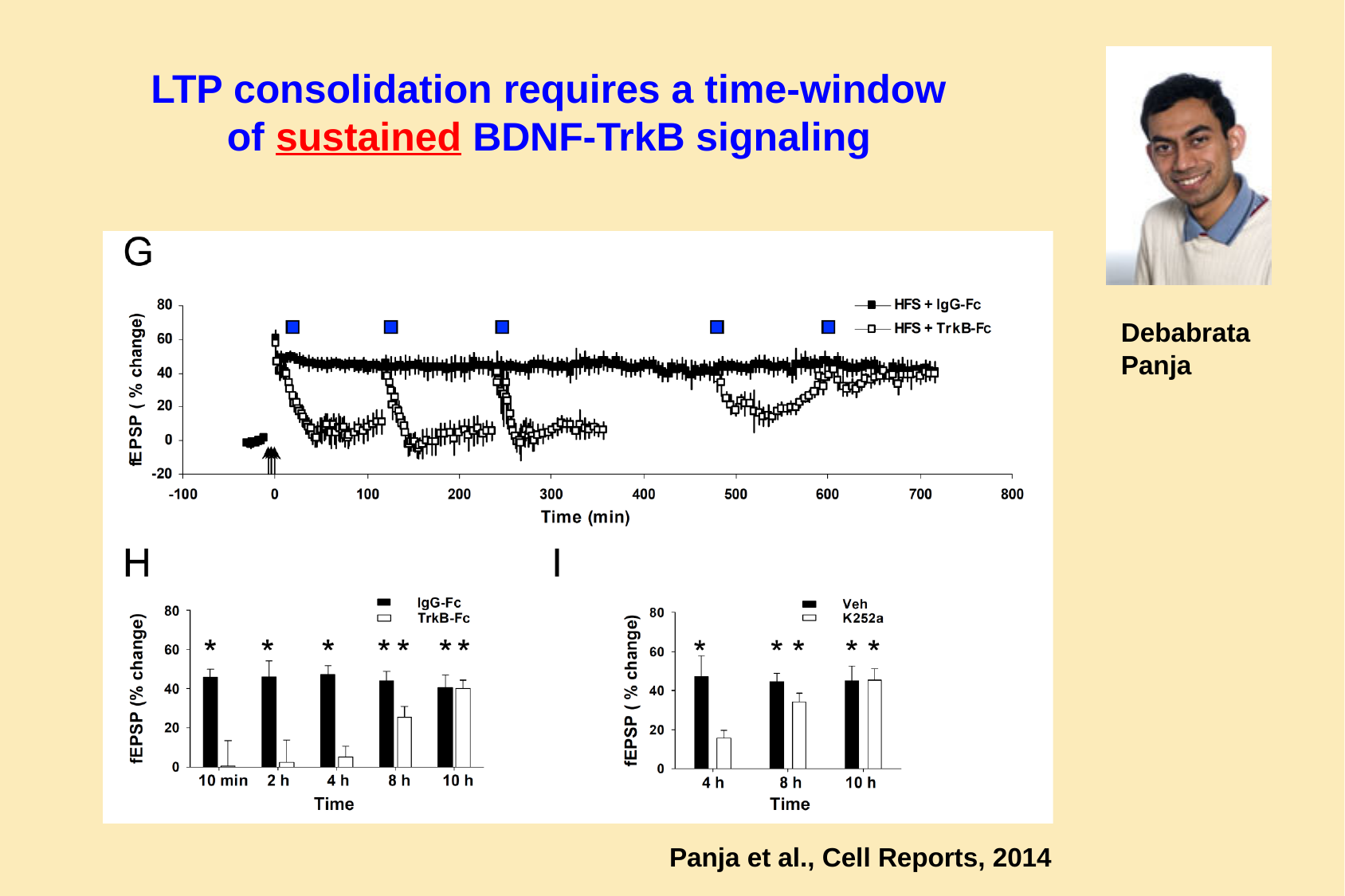
In chart H (bottom left), which series has the larger value at 8 h, IgG-Fc or TrkB-Fc? IgG-Fc In chart G (the top chart), which series has the higher value at 100 min, HFS + IgG-Fc or HFS + TrkB-Fc? HFS + IgG-Fc In chart H (bottom left), is the TrkB-Fc value at 10 min greater or less than 20? less How many time categories are shown on the x axis of chart H (bottom left)? 5 In chart G (the top chart), is the value for HFS + IgG-Fc at 300 min greater or less than 20? greater What is the x-axis label of chart G (the top chart)? Time (min) In chart H (bottom left), at which time is the TrkB-Fc value highest? 10 h How many series does the legend of chart G (the top chart) list? 2 What kind of chart is chart H (bottom left)? bar chart What kind of chart is chart G (the top chart)? line chart In chart G (the top chart), is the value for HFS + TrkB-Fc at 100 min greater or less than 20? less What are the two legend entries in chart I (bottom right)? Veh and K252a